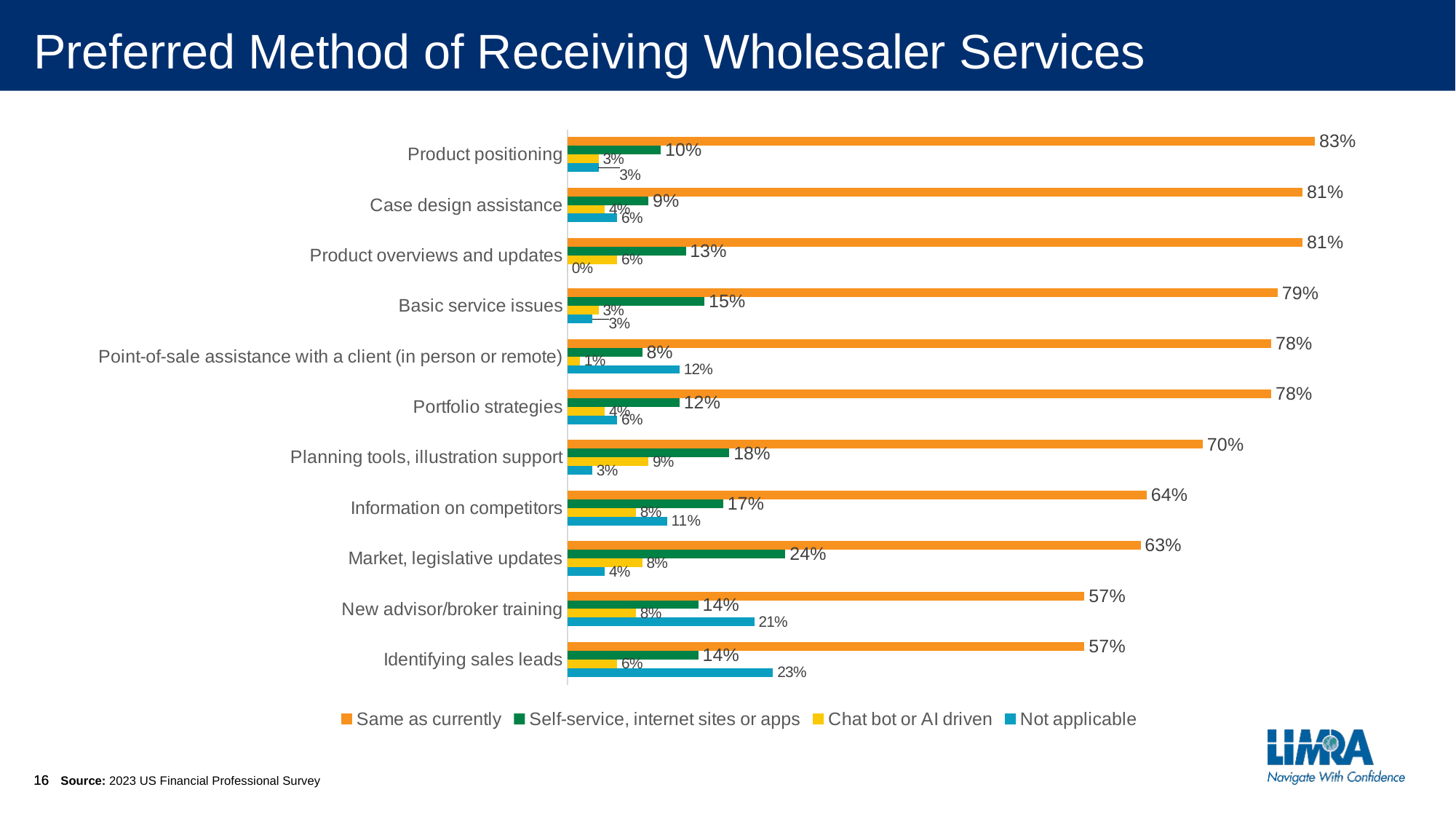
Which is larger: the 'Not applicable' value for New advisor/broker training or for Information on competitors? New advisor/broker training What is the 'Self-service, internet sites or apps' value for Market, legislative updates? 24% Which category has the highest 'Same as currently' value? Product positioning How many categories are shown on the chart? 11 What is the 'Not applicable' value for Identifying sales leads? 23% What is the 'Same as currently' value for Product positioning? 83% What is the title of the slide? Preferred Method of Receiving Wholesaler Services Which category has the highest 'Self-service, internet sites or apps' value? Market, legislative updates How many series does the legend list? 4 What is the 'Chat bot or AI driven' value for Planning tools, illustration support? 9% What is the difference between the 'Same as currently' values for Product positioning and Identifying sales leads? 26% What kind of chart is shown on the slide? Bar chart